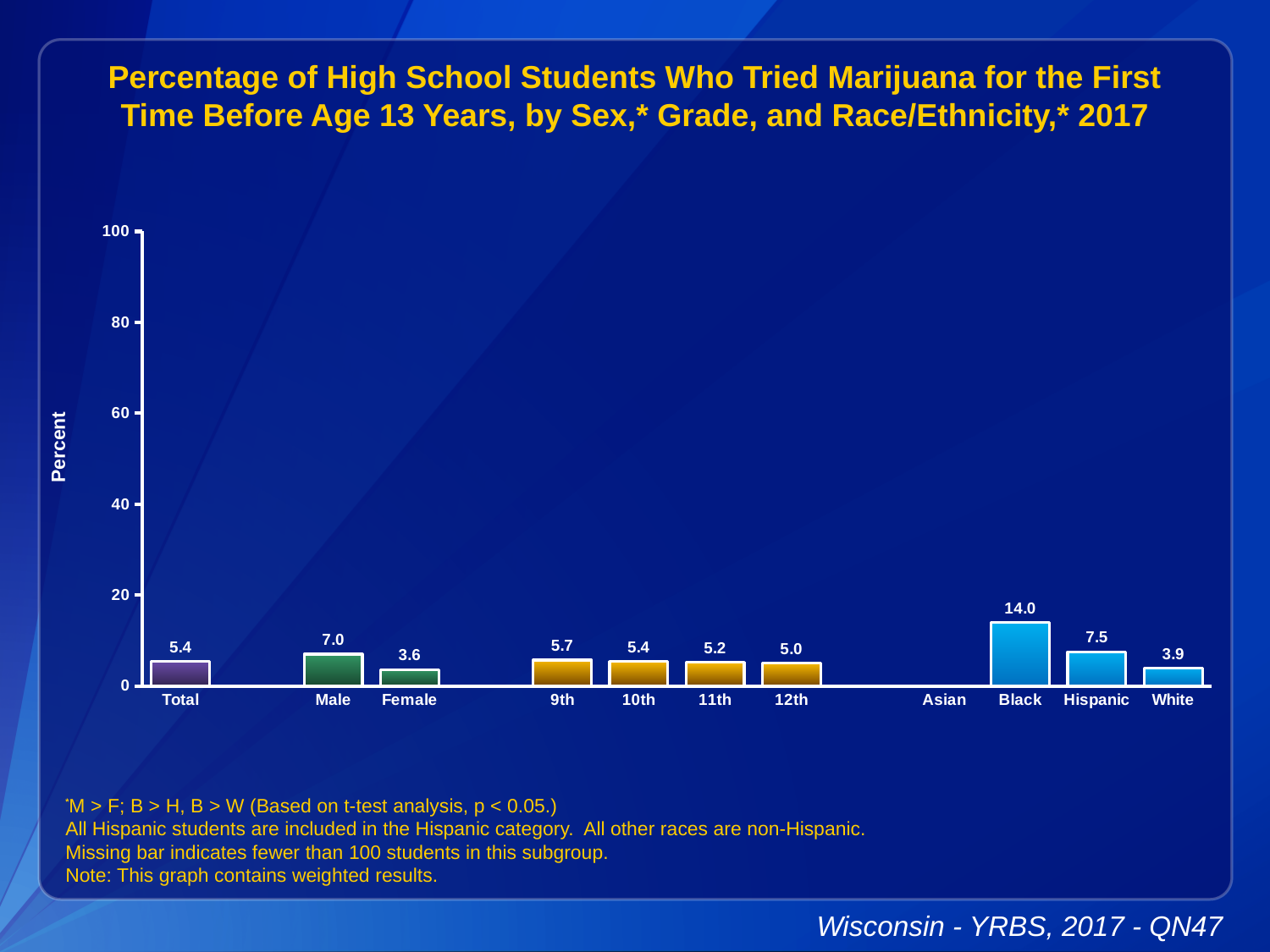
What is the value for 12th grade? 5.0 What is the value for Male? 7.0 Is the value for Black greater or less than 20? less Which is larger, the value for Hispanic or the value for White? Hispanic What kind of chart is shown on the slide? bar chart What is the difference between the Male and Female values? 3.4 Which category label has no bar plotted? Asian Which category has the highest value? Black What is the value for Black? 14.0 Do the values rise or fall from 9th grade to 12th grade? fall What is the value for Total? 5.4 Which category has the lowest plotted value? Female